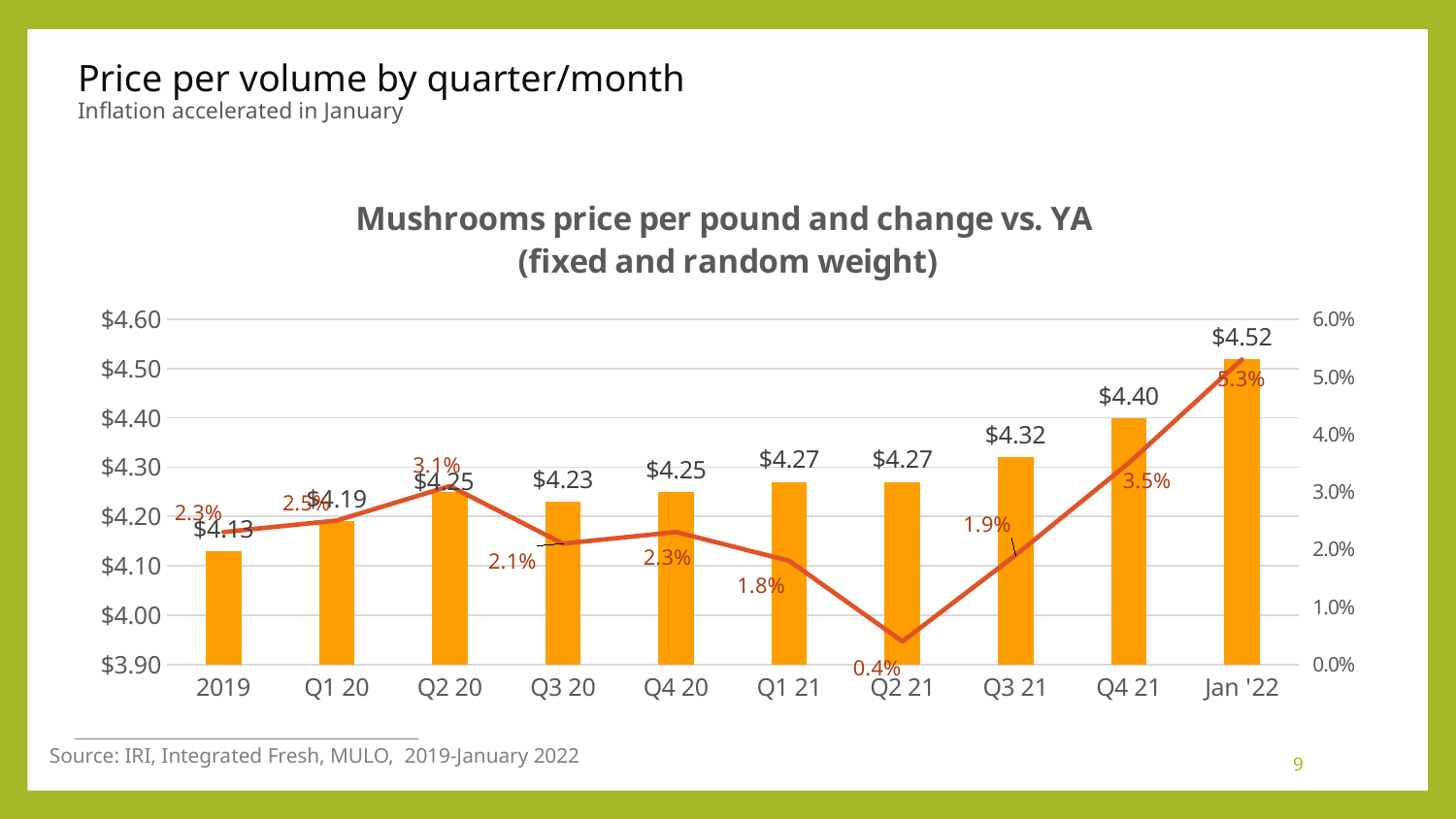
Is the change vs. YA for Jan '22 greater or less than 5.0%? greater What is the difference in price per pound between Jan '22 and Q4 21? $0.12 Which period has the highest price per pound? Jan '22 What is the change vs. YA shown for Q4 21? 3.5% What is the mushrooms price per pound for 2019? $4.13 Which period has the lowest change vs. YA? Q2 21 What kind of chart is this? Combined bar and line chart Does the price per pound rise or fall from Q2 21 to Jan '22? Rise What is the change vs. YA shown for Q2 21? 0.4% How many periods are shown on the x axis? 10 What is the mushrooms price per pound for Jan '22? $4.52 Which is larger, the price per pound in Q3 20 or in Q4 20? Q4 20